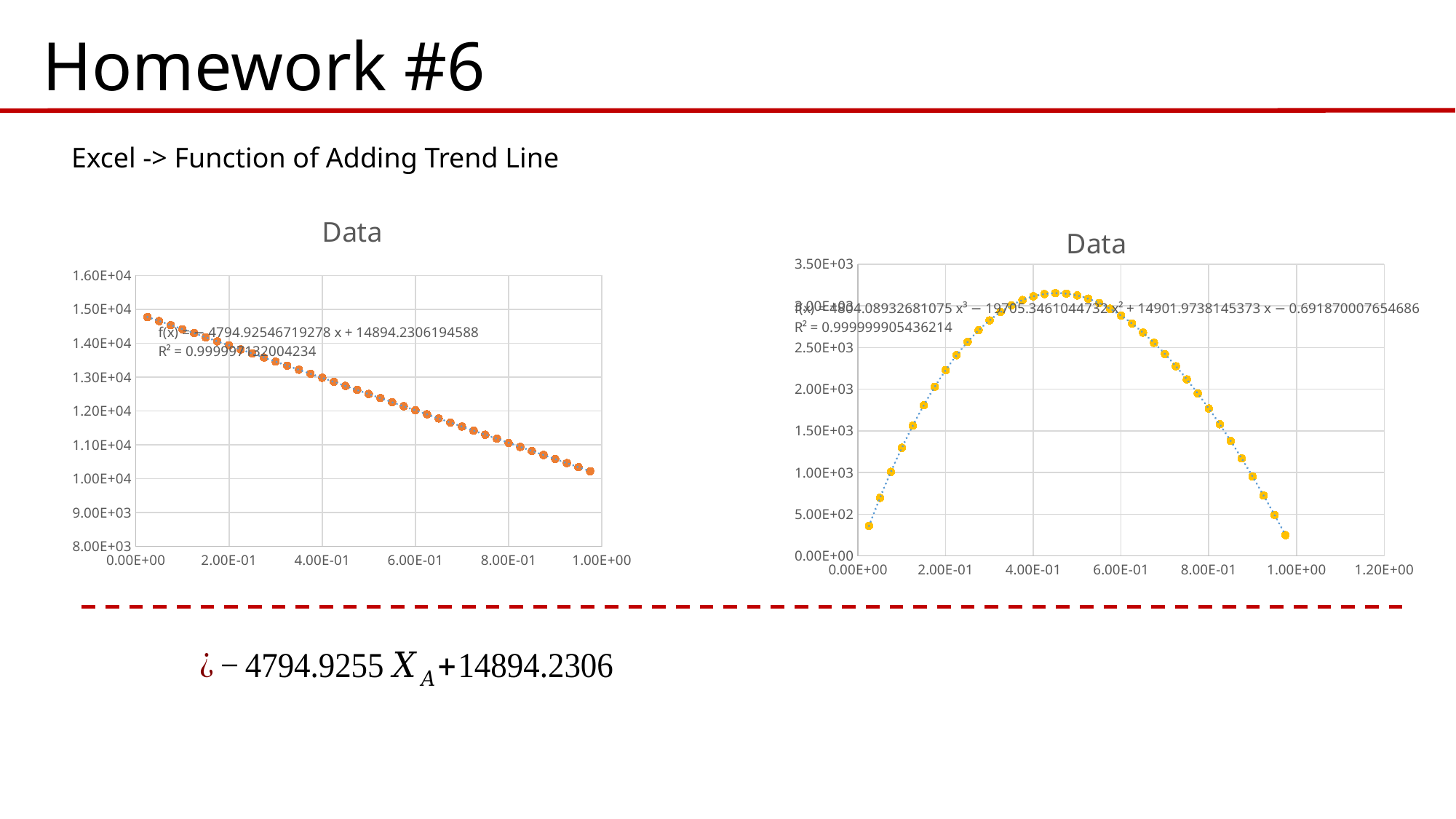
In the left chart, is the value of the last point (near x = 1.00E+00) greater or less than 1.10E+04? less In the right chart, which has the larger value: the point near x = 4.00E-01 or the point near x = 1.00E+00? the point near x = 4.00E-01 What is the highest tick label on the y axis of the right chart? 3.50E+03 In the left chart, is the value of the first point (near x = 0.00E+00) greater or less than 1.40E+04? greater In the left chart, do the plotted values rise or fall as x increases from 0.00E+00 to 1.00E+00? fall In the left chart, which has the larger value: the point near x = 2.00E-01 or the point near x = 8.00E-01? the point near x = 2.00E-01 What kind of chart is the left chart titled "Data"? scatter chart What kind of chart is the right chart titled "Data"? scatter chart What R² value is shown on the right chart? 0.999999905436214 In the right chart, is the highest plotted value greater or less than 3.00E+03? greater In the right chart, how do the plotted values change as x increases from 0.00E+00 to 1.00E+00? rise then fall